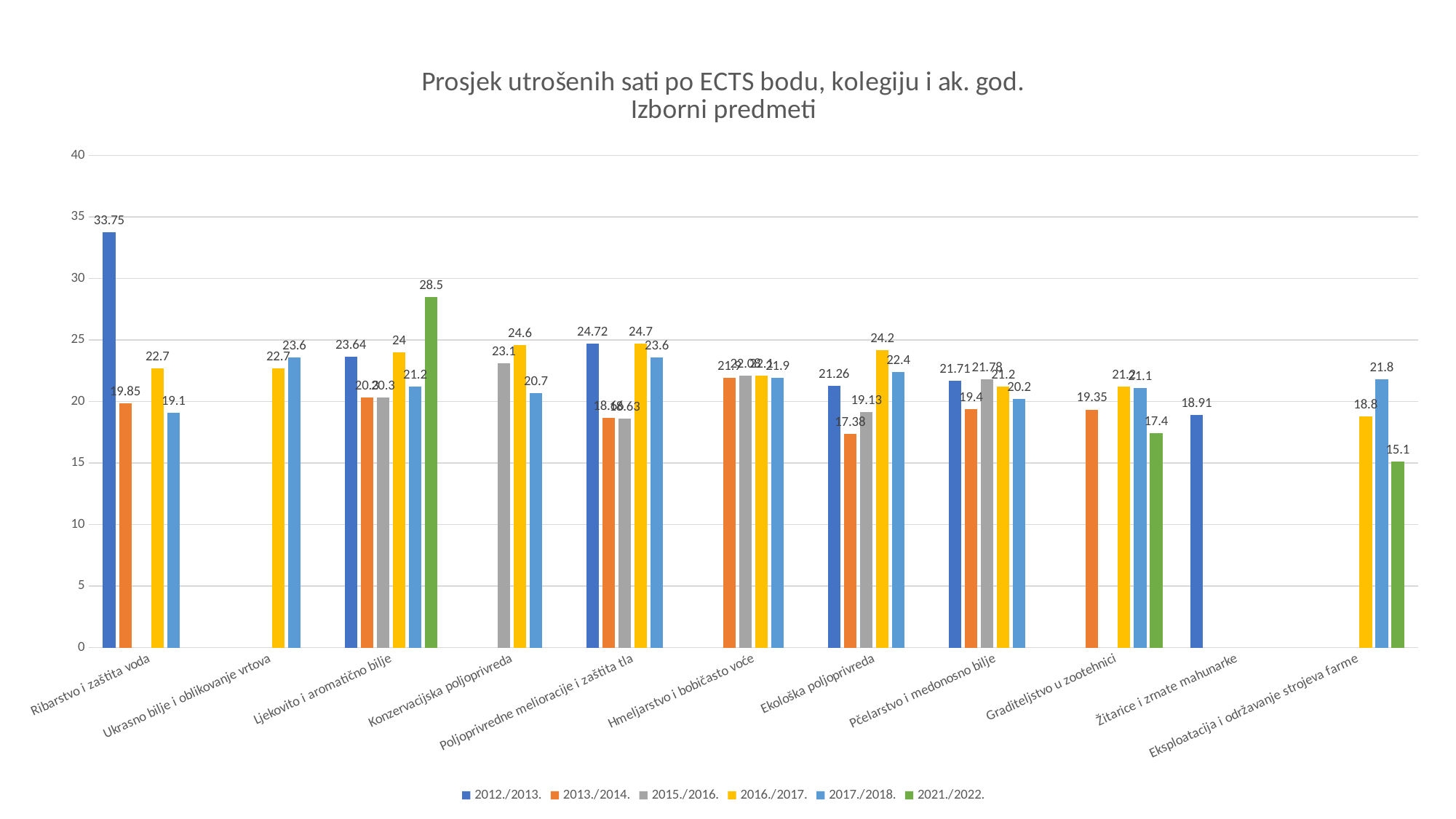
How many courses (categories) are shown on the x axis? 11 What is the difference between the 2016./2017. and 2013./2014. values for Ekološka poljoprivreda? 6.82 What kind of chart is shown on the slide? bar chart Is the value for Ribarstvo i zaštita voda in 2012./2013. greater or less than 30? greater What is the value for Ljekovito i aromatično bilje in 2021./2022.? 28.5 What is the title of the chart? Prosjek utrošenih sati po ECTS bodu, kolegiju i ak. god. Izborni predmeti What is the value for Žitarice i zrnate mahunarke in 2012./2013.? 18.91 For Konzervacijska poljoprivreda, which year has the larger value, 2016./2017. or 2017./2018.? 2016./2017. Which course has the highest bar in the chart? Ribarstvo i zaštita voda What is the value for Ribarstvo i zaštita voda in 2012./2013.? 33.75 Which course has the lowest bar in the chart? Eksploatacija i održavanje strojeva farme How many series does the legend list? 6